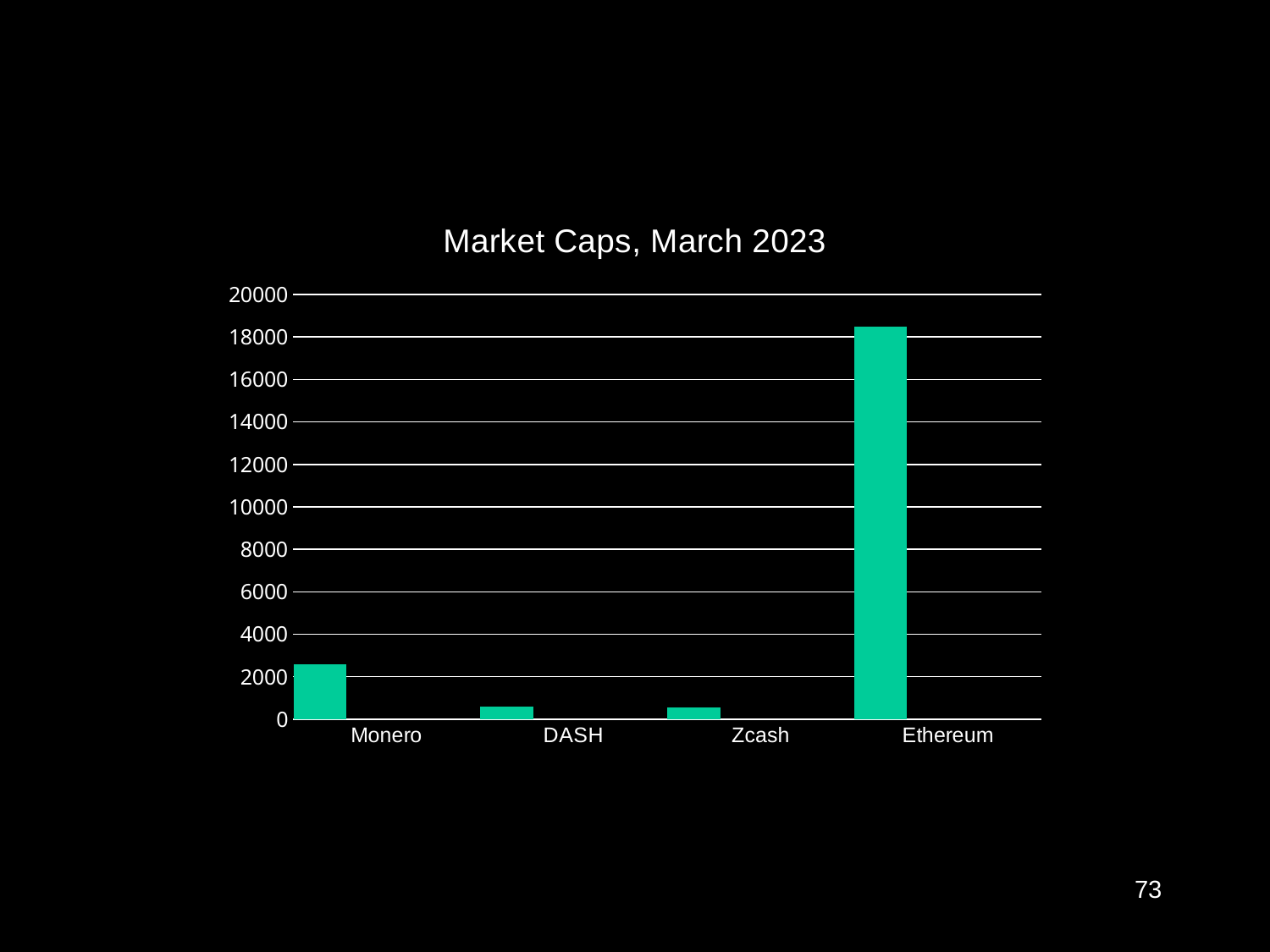
Is the value for DASH greater or less than 2000? less Is the value for Ethereum greater or less than 16000? greater How many categories are shown on the x axis? 4 What is the highest value shown on the y axis? 20000 Which is larger, the value for Zcash or the value for Ethereum? Ethereum Is the value for Zcash greater or less than 2000? less Which is larger, the value for Ethereum or the value for Monero? Ethereum What kind of chart is shown on the slide? bar chart What is the title of the chart? Market Caps, March 2023 Which is larger, the value for Monero or the value for DASH? Monero Which category has the highest market cap? Ethereum